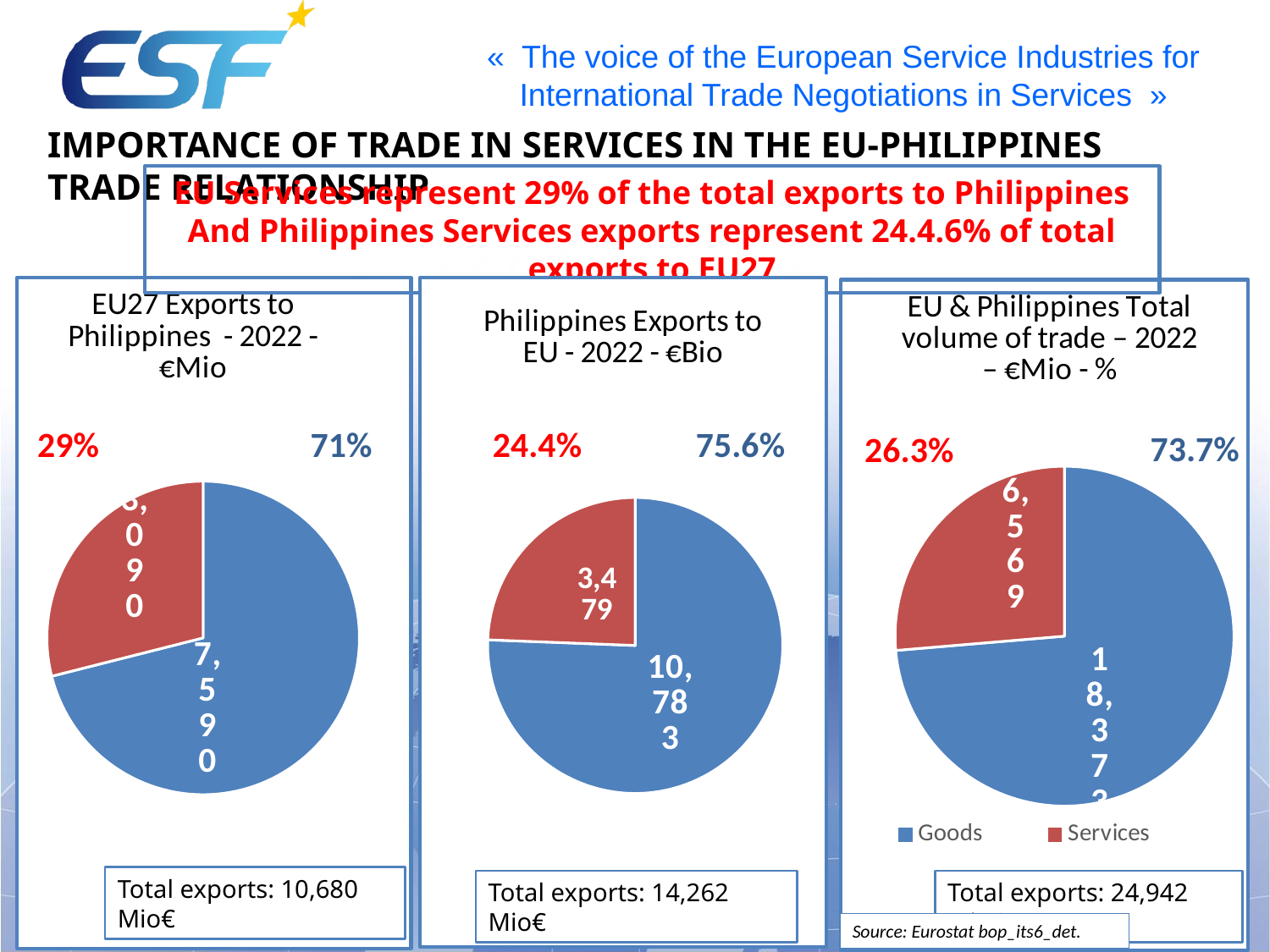
In the 'EU & Philippines Total volume of trade – 2022' chart, which category has the largest slice? Goods In the 'Philippines Exports to EU - 2022 - €Bio' chart, what is the value for Services? 3,479 In the legend of the 'EU & Philippines Total volume of trade' chart, which colour represents Services? Red In the 'Philippines Exports to EU - 2022 - €Bio' chart, what is the difference between the Goods value and the Services value? 7,304 In the 'EU & Philippines Total volume of trade – 2022' chart, what is the value for Services? 6,569 In the 'Philippines Exports to EU - 2022 - €Bio' chart, what share of the pie is Services? 24.4% In the 'EU27 Exports to Philippines - 2022 - €Mio' chart, what share of the pie is Goods? 71% In the 'EU & Philippines Total volume of trade – 2022' chart, what share of the pie is Services? 26.3% In the 'EU27 Exports to Philippines - 2022 - €Mio' chart, what is the value for Goods? 7,590 How many entries does the legend under the 'EU & Philippines Total volume of trade' chart list? 2 In the 'Philippines Exports to EU - 2022 - €Bio' chart, what is the value for Goods? 10,783 What kind of chart is used on this slide for the three charts? Pie chart